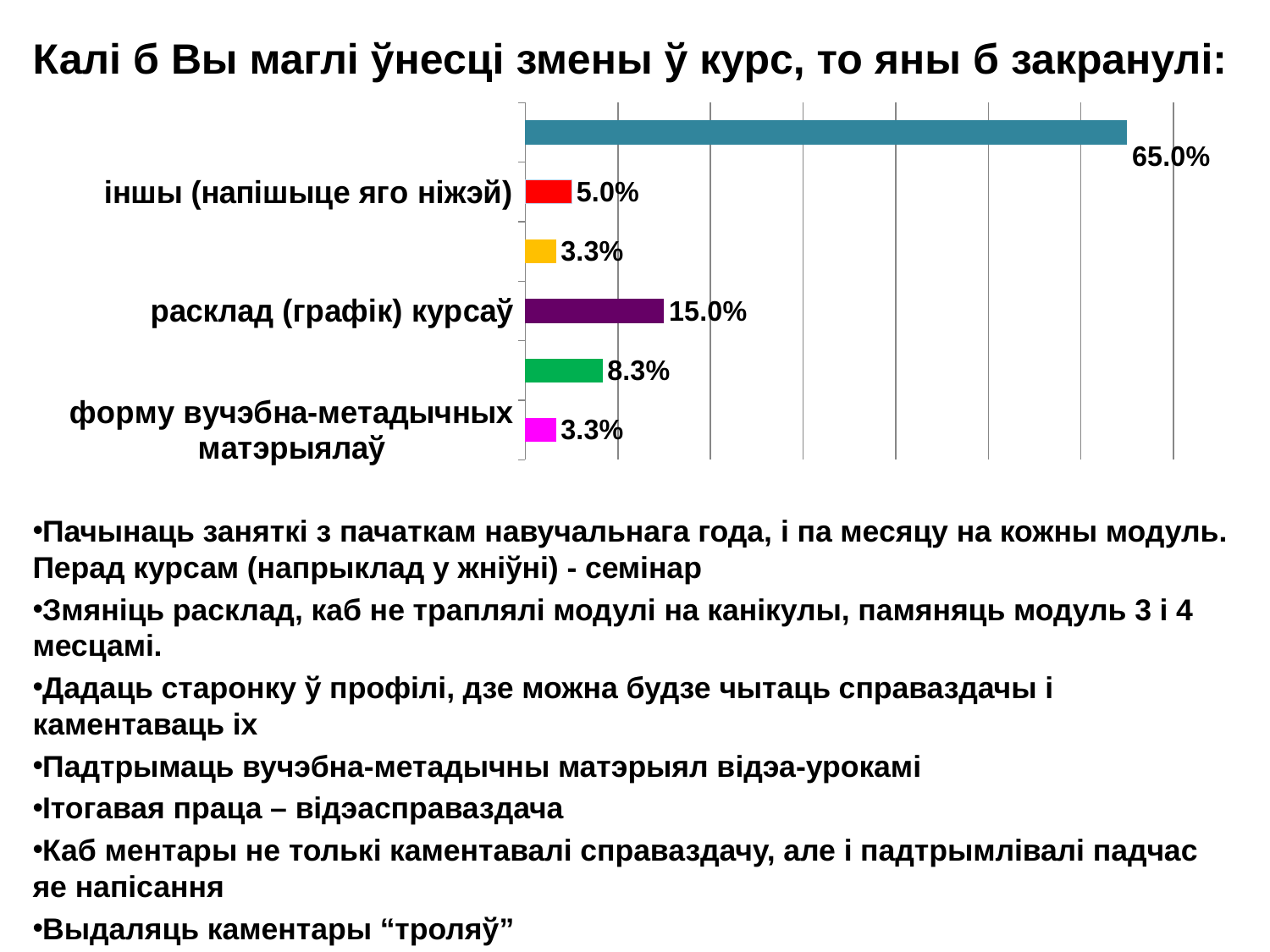
What colour is the bar for "іншы (напішыце яго ніжэй)"? Red What kind of chart is shown on the slide? Bar chart What is the difference between the values for "расклад (графік) курсаў" and "іншы (напішыце яго ніжэй)"? 10.0% What colour is the bar for "расклад (графік) курсаў"? Purple What is the largest value shown on the chart? 65.0% How many bars are plotted on the chart? 6 What is the value for "іншы (напішыце яго ніжэй)"? 5.0% What is the value for "расклад (графік) курсаў"? 15.0% What is the smallest value shown on the chart? 3.3% What is the value for "форму вучэбна-метадычных матэрыялаў"? 3.3% Which has a larger value, "расклад (графік) курсаў" or "іншы (напішыце яго ніжэй)"? расклад (графік) курсаў Which has a larger value, "іншы (напішыце яго ніжэй)" or "форму вучэбна-метадычных матэрыялаў"? іншы (напішыце яго ніжэй)